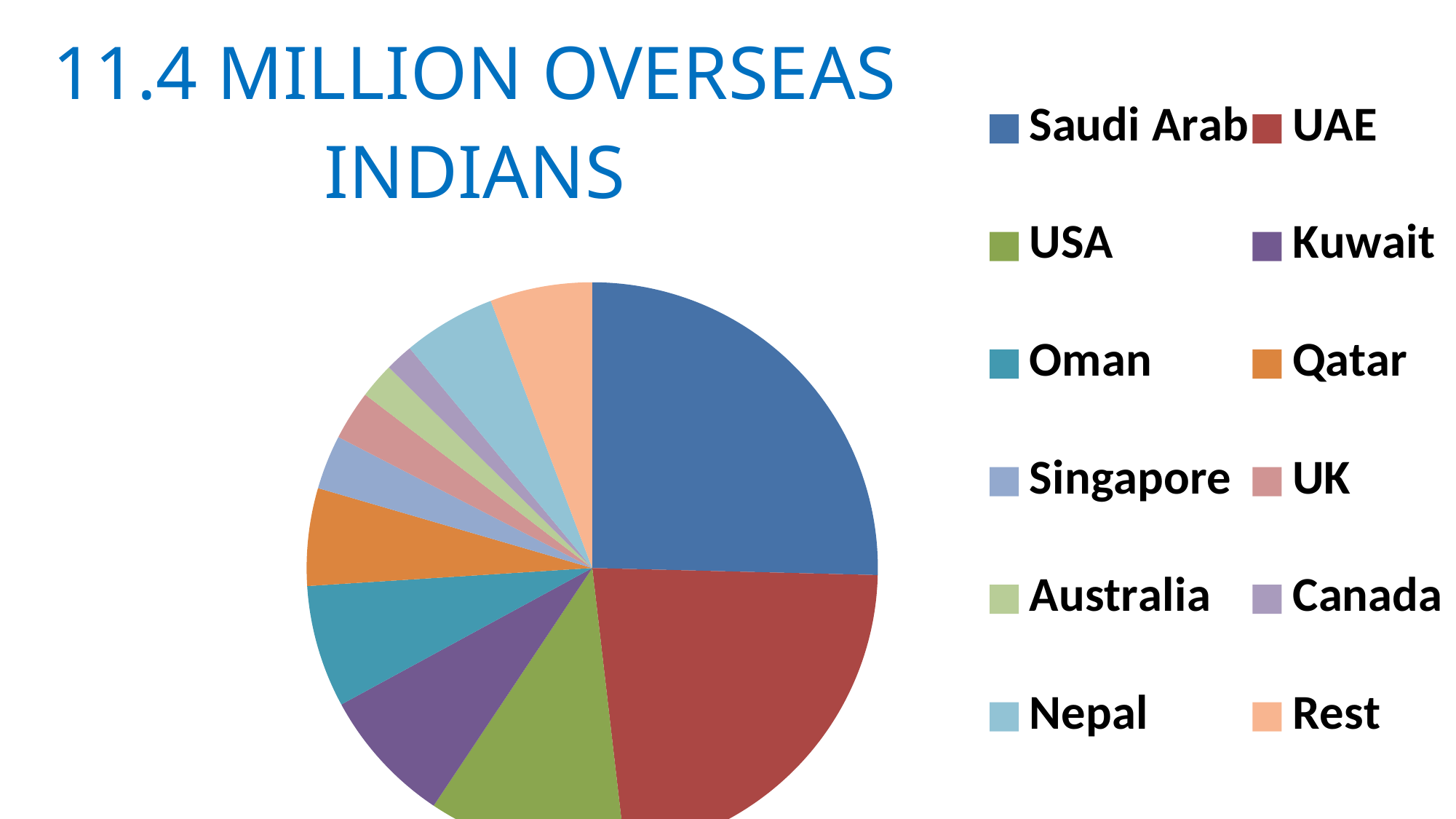
What kind of chart is shown on the slide? pie chart Which slice is larger in the pie chart, Kuwait or Singapore? Kuwait What is the title of the slide containing the pie chart? 11.4 MILLION OVERSEAS INDIANS How many entries does the legend of the pie chart list? 12 Which slice is larger in the pie chart, Saudi Arab or Qatar? Saudi Arab Which slice is larger in the pie chart, Rest or Australia? Rest Which colour represents Saudi Arab in the pie chart? blue How many slices does the pie chart have? 12